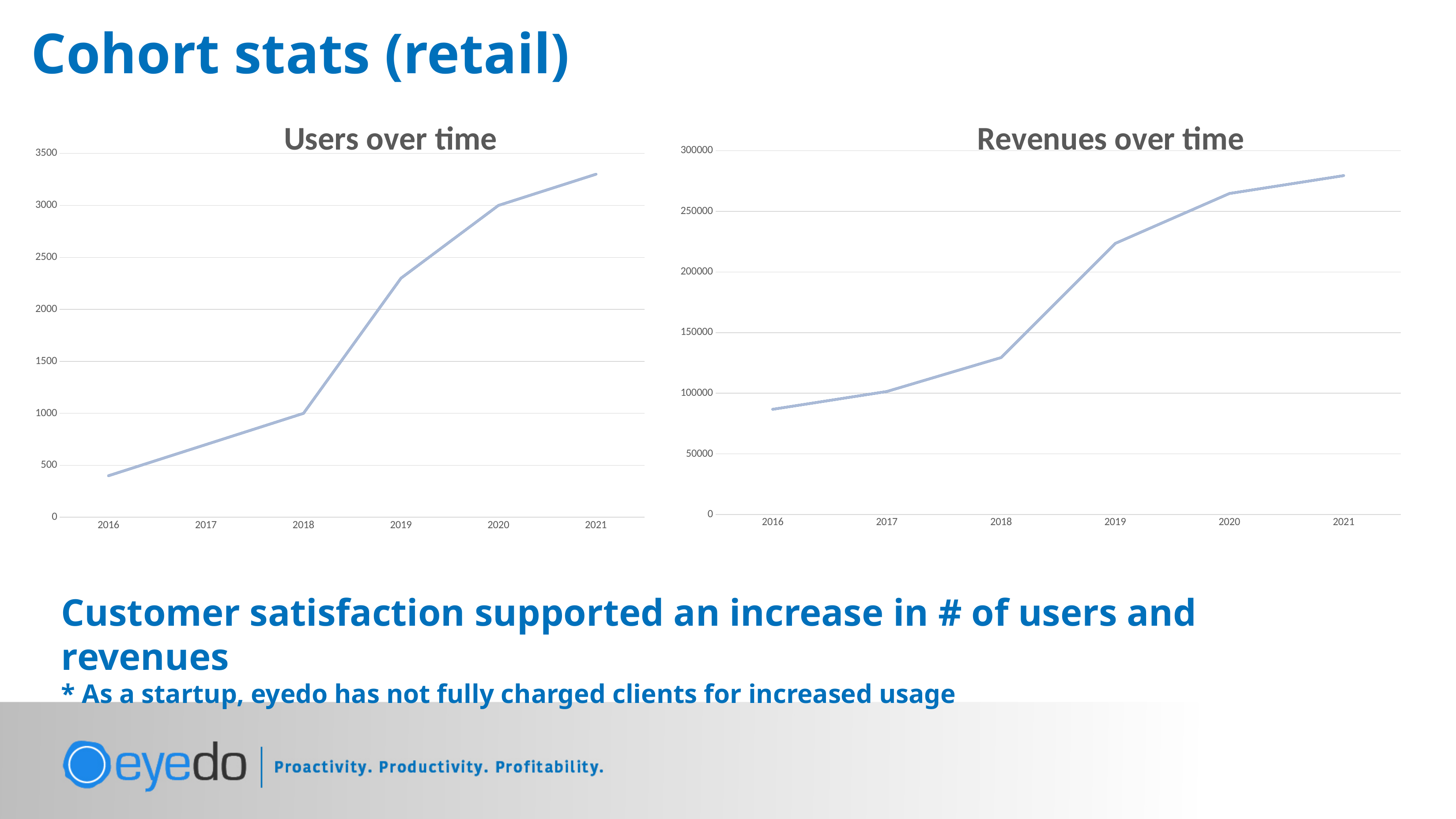
In the "Users over time" chart, which year has the lowest value? 2016 What is the title of the chart on the right side of the slide? Revenues over time In the "Users over time" chart, how many years are plotted on the x axis? 6 In the "Revenues over time" chart, is the value for 2019 greater or less than 200000? greater In the "Users over time" chart, is the value for 2016 greater or less than 500? less In the "Users over time" chart, do the values rise or fall from 2016 to 2021? rise What kind of chart is the "Users over time" chart? line chart In the "Revenues over time" chart, which year has the highest value? 2021 In the "Users over time" chart, which year has the highest value? 2021 In the "Users over time" chart, is the value for 2019 greater or less than 2000? greater In the "Revenues over time" chart, which is larger, the value for 2018 or the value for 2020? 2020